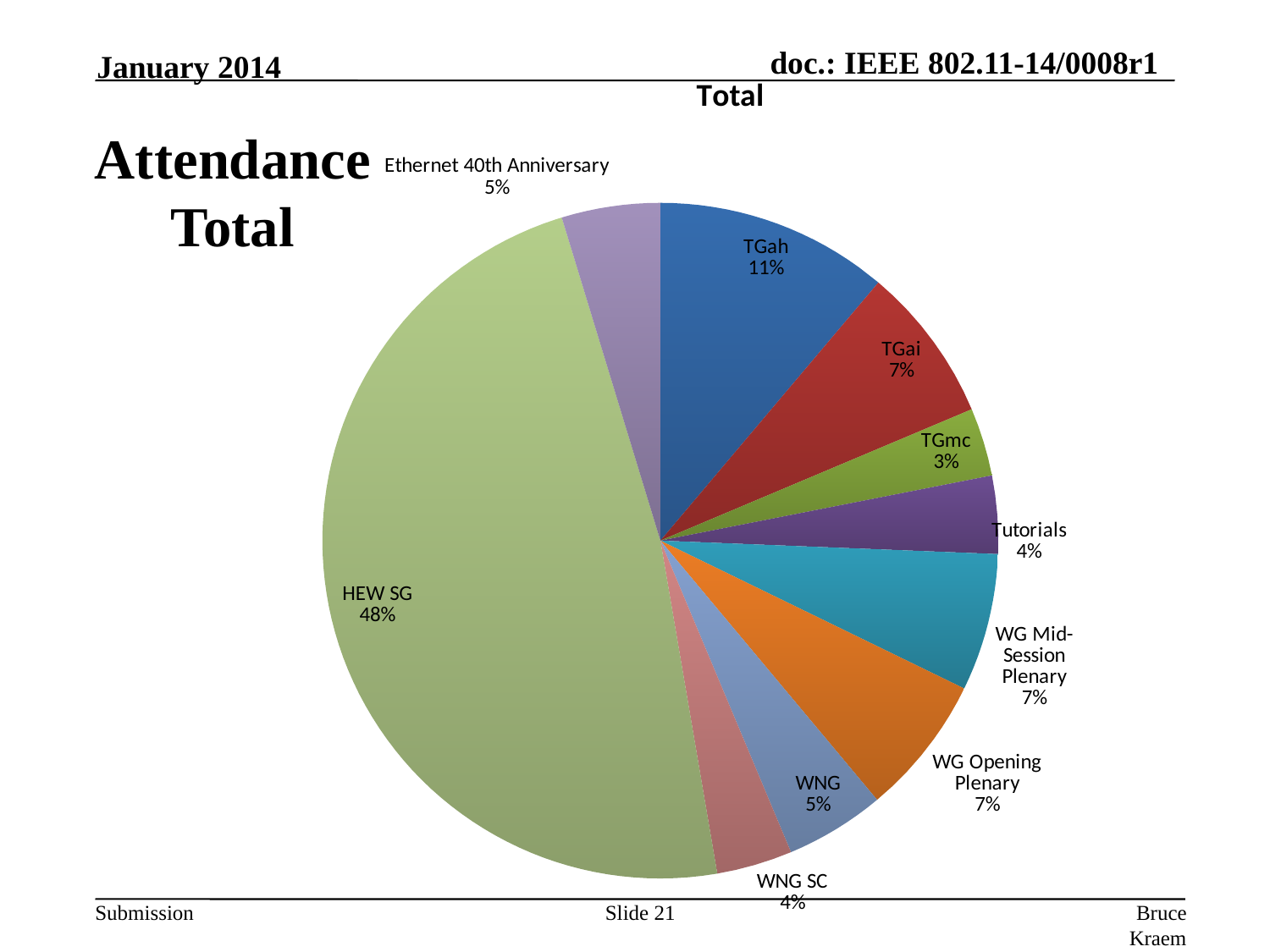
Which category has the largest slice of the pie? HEW SG What share of the pie does HEW SG have? 48% What share of the pie does WG Mid-Session Plenary have? 7% What kind of chart is shown on the slide? pie chart Which category has the smallest slice of the pie? TGmc What is the title of the chart? Total What share of the pie does TGmc have? 3% What is the difference in percentage points between HEW SG and TGah? 37 How many slices does the pie chart have? 10 Which is larger, the slice for TGai or the slice for Tutorials? TGai